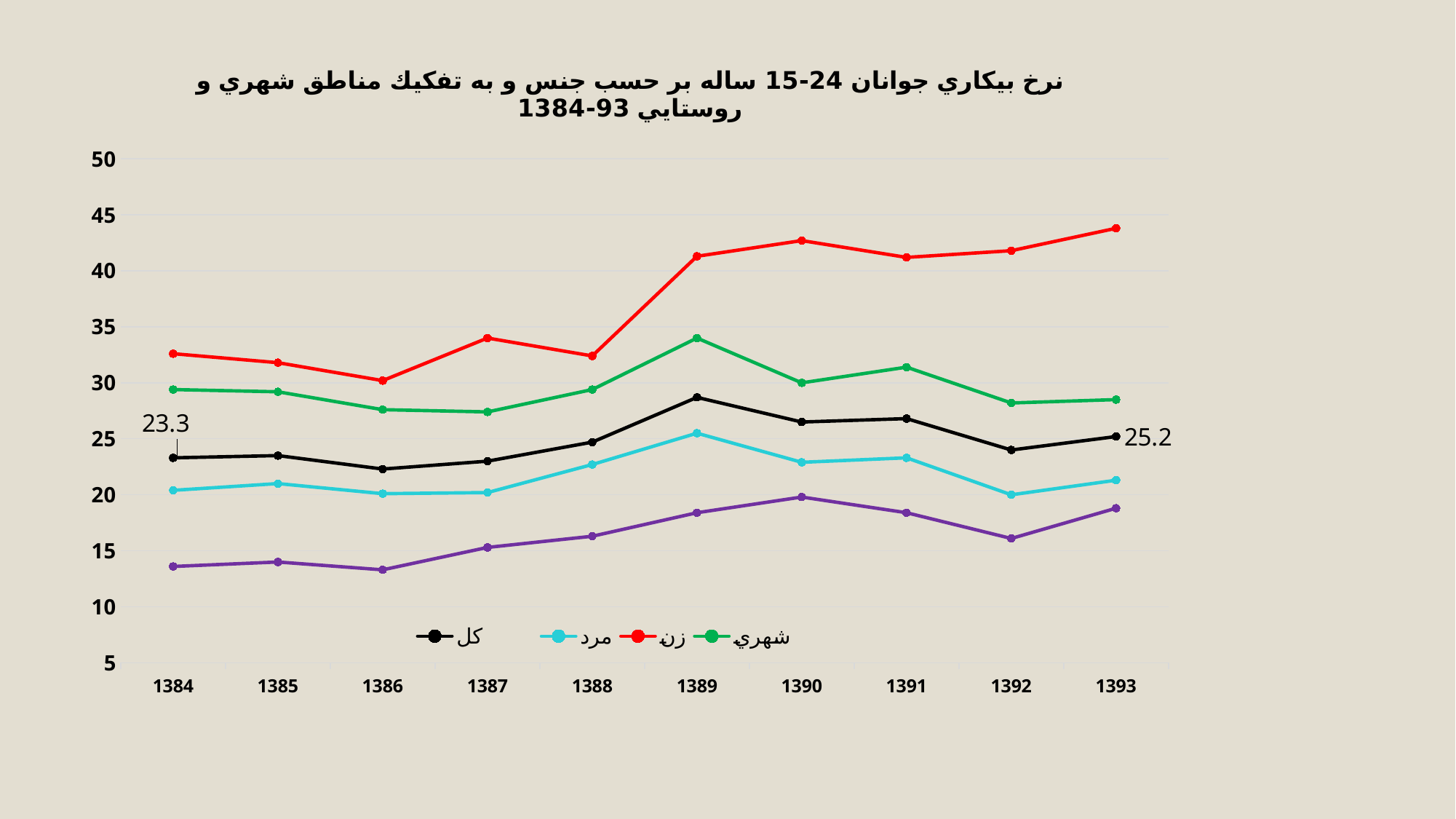
How many series does the legend list? 4 In 1389, which series has the larger value, زن or شهري? زن Is the value for مرد in 1386 greater or less than 25? less What kind of chart is shown on the slide? line chart How many years are plotted along the x axis? 10 What is the value of the كل series in 1384? 23.3 In which year does the كل series reach its highest value? 1389 Is the value for زن in 1389 greater or less than 40? greater By how much does the كل series value in 1393 exceed its value in 1384? 1.9 Is the value of the كل series in 1393 higher or lower than in 1384? higher What is the value of the كل series in 1393? 25.2 Which series has the highest values across the whole chart? زن